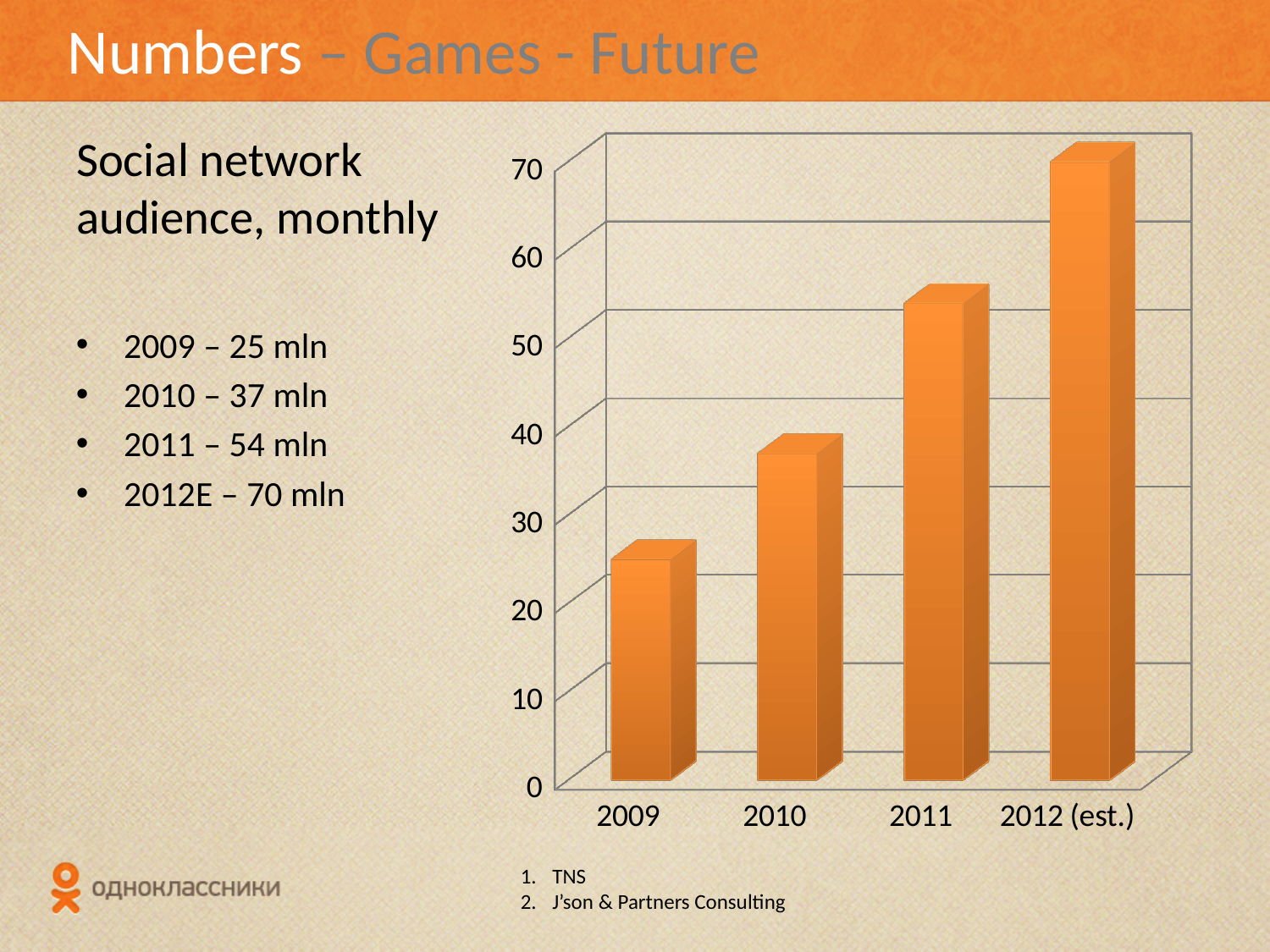
How many categories (years) are shown on the x axis of the chart? 4 Which year has the lowest bar in the chart? 2009 What is the estimated social network monthly audience for 2012? 70 mln Is the bar for 2011 greater or less than 50? greater Do the values rise or fall from 2009 to 2012 (est.)? rise What is the social network monthly audience for 2009? 25 mln What is the difference between the 2010 and 2009 audience values? 12 mln Which year has the highest bar in the chart? 2012 (est.) What type of chart is shown on the slide? bar chart Is the bar for 2010 greater or less than 40? less Which is larger, the bar for 2010 or the bar for 2011? 2011 What is the social network monthly audience for 2011? 54 mln